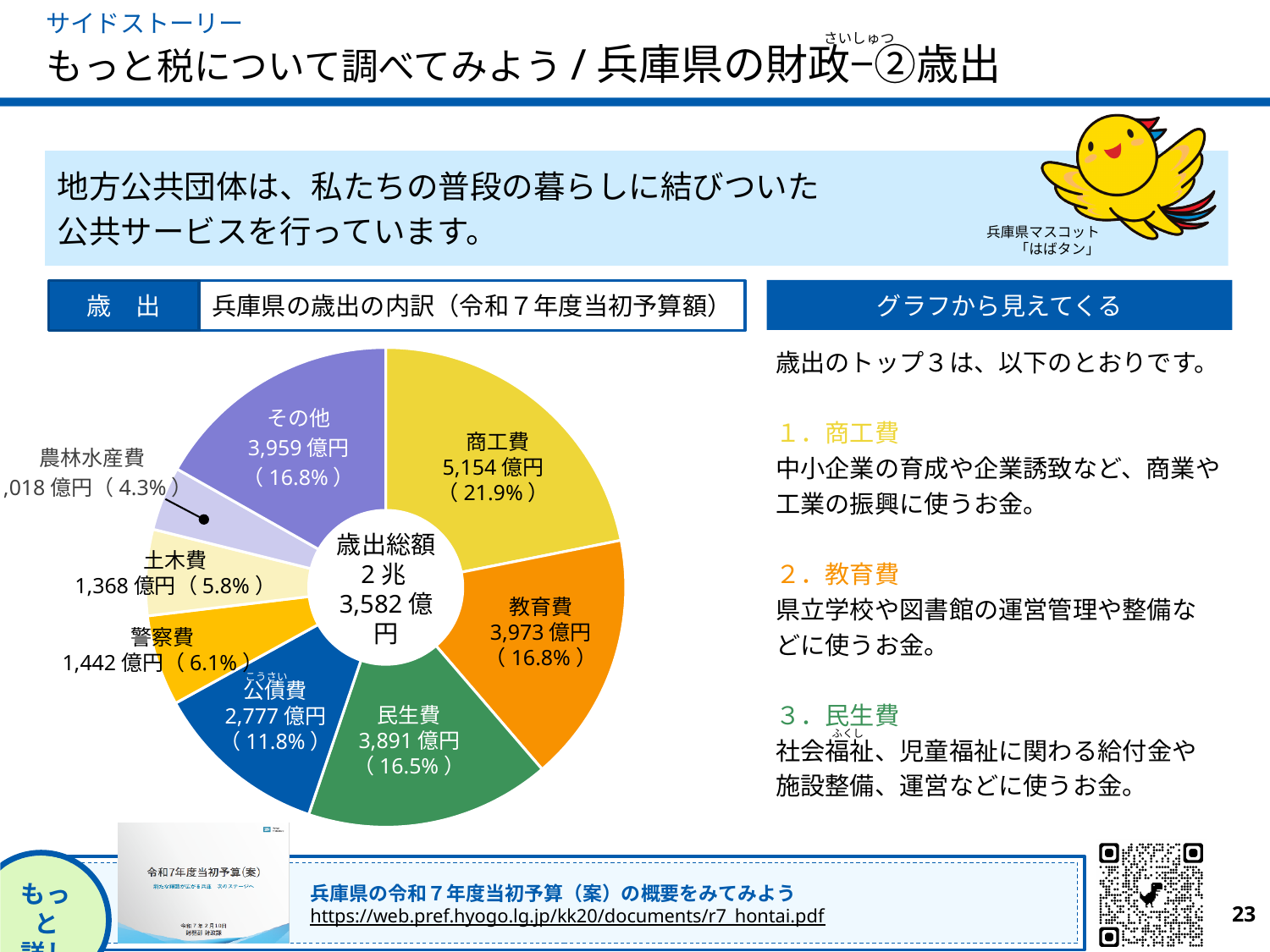
円グラフで、商工費と教育費の金額の差はいくらですか？ 1,181 億円 円グラフには費目がいくつ示されていますか？ 8 円グラフで、公債費の金額はいくらですか？ 2,777 億円 このスライドのグラフはどの種類のグラフですか？ 円グラフ 円グラフで、最も割合が小さい費目はどれですか？ 農林水産費 円グラフで、教育費の割合は何％ですか？ 16.8% 円グラフで、最も金額が大きい費目はどれですか？ 商工費 円グラフの中央に示されている歳出総額はいくらですか？ 2兆3,582億円 円グラフで、商工費の金額はいくらですか？ 5,154 億円 円グラフのタイトルは何ですか？ 兵庫県の歳出の内訳（令和７年度当初予算額） 円グラフで、警察費と土木費ではどちらの金額が大きいですか？ 警察費 円グラフで、民生費の割合は何％ですか？ 16.5%